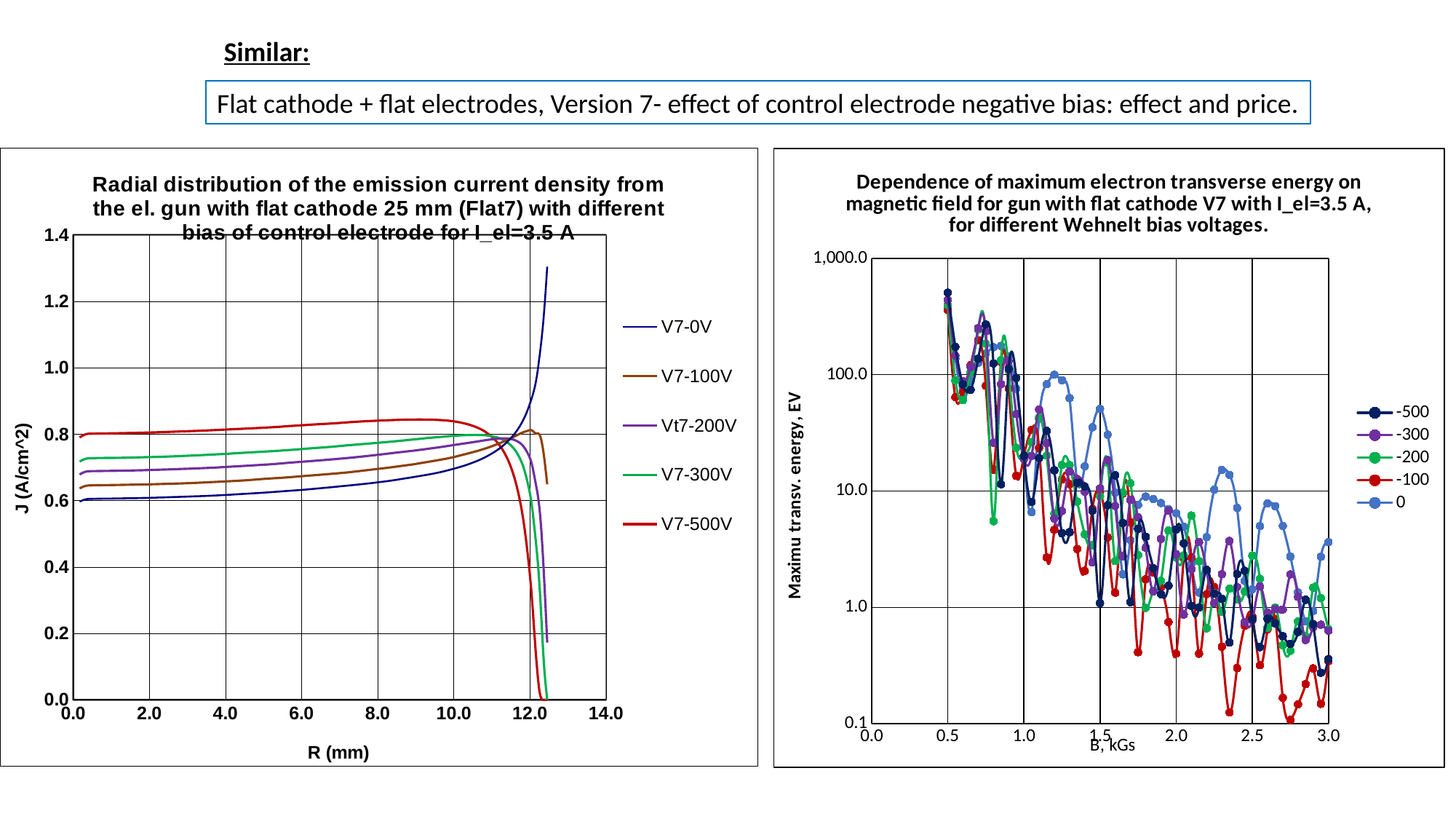
In the left chart, is the value of V7-0V at R = 2.0 mm greater or less than 0.8? less In the left chart, does the V7-0V curve rise or fall as R increases from 0 to 12 mm? rise In the left chart, which series has the highest value at R = 2.0 mm? V7-500V In the left chart, at R = 4.0 mm, which is larger: V7-100V or Vt7-200V? Vt7-200V How many series does the legend of the left chart list? 5 What kind of chart is the left chart, 'Radial distribution of the emission current density'? line chart In the left chart, which series has the lowest value at R = 2.0 mm? V7-0V How many series does the legend of the right chart list? 5 What kind of chart is the right chart, 'Dependence of maximum electron transverse energy on magnetic field'? line chart In the left chart, is the value of V7-500V at R = 2.0 mm greater or less than 0.6? greater What is the x-axis label of the right chart? B, kGs In the right chart, is the value of the '0' series at B = 1.2 kGs greater or less than 10.0? greater